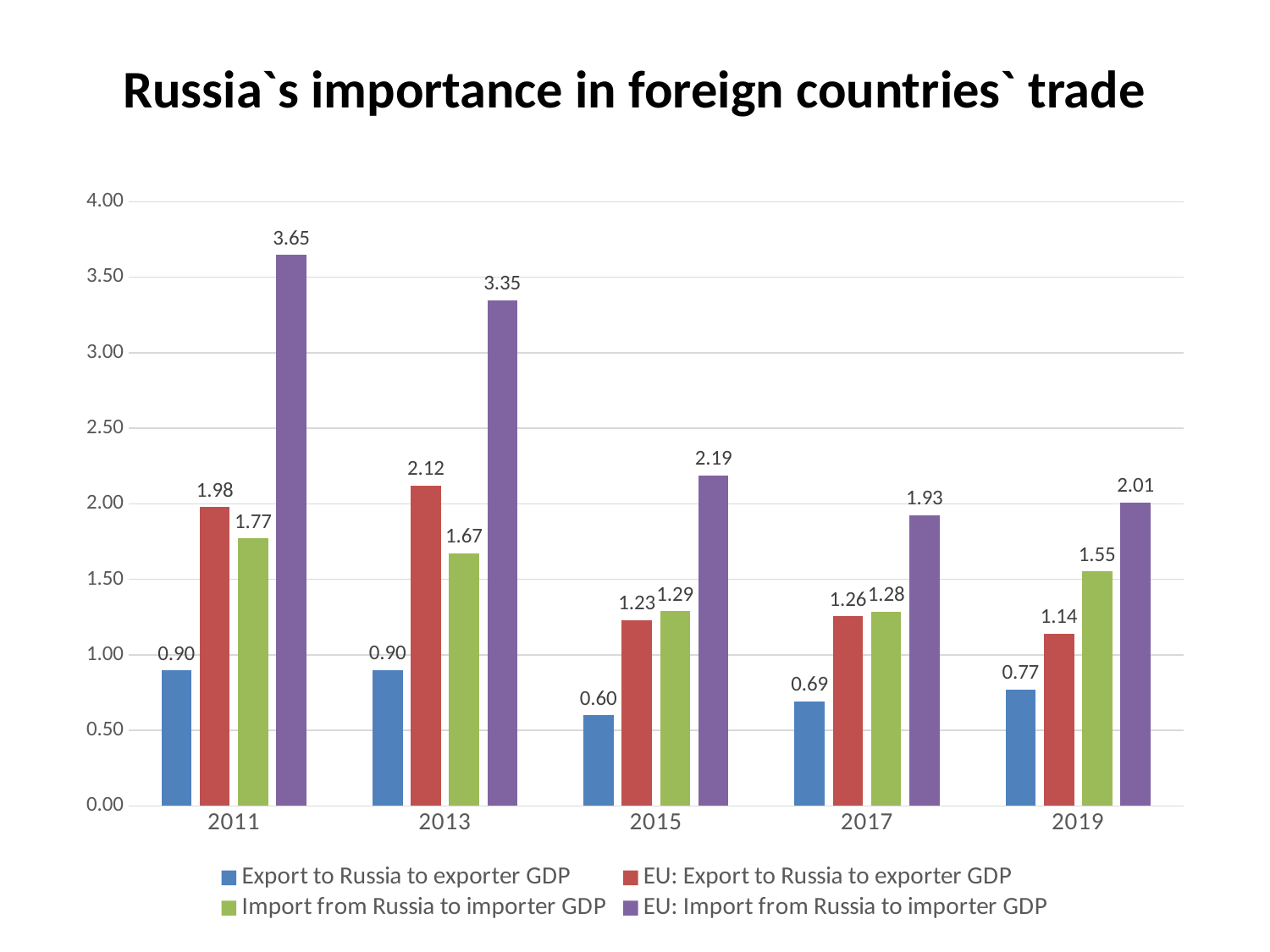
How many series does the legend list? 4 Is the value for "EU: Import from Russia to importer GDP" in 2017 greater or less than 1.50? greater What is the value of "Export to Russia to exporter GDP" in 2015? 0.60 Which is larger in 2019: "EU: Export to Russia to exporter GDP" or "Import from Russia to importer GDP"? Import from Russia to importer GDP In which year is "Export to Russia to exporter GDP" lowest? 2015 Does "EU: Import from Russia to importer GDP" rise or fall from 2011 to 2015? fall What is the value of "Import from Russia to importer GDP" in 2019? 1.55 In which year is "EU: Export to Russia to exporter GDP" highest? 2013 What is the value of "EU: Import from Russia to importer GDP" in 2011? 3.65 How many years are shown on the x axis? 5 What is the difference between "EU: Import from Russia to importer GDP" in 2011 and in 2013? 0.30 What kind of chart is shown on the slide? bar chart